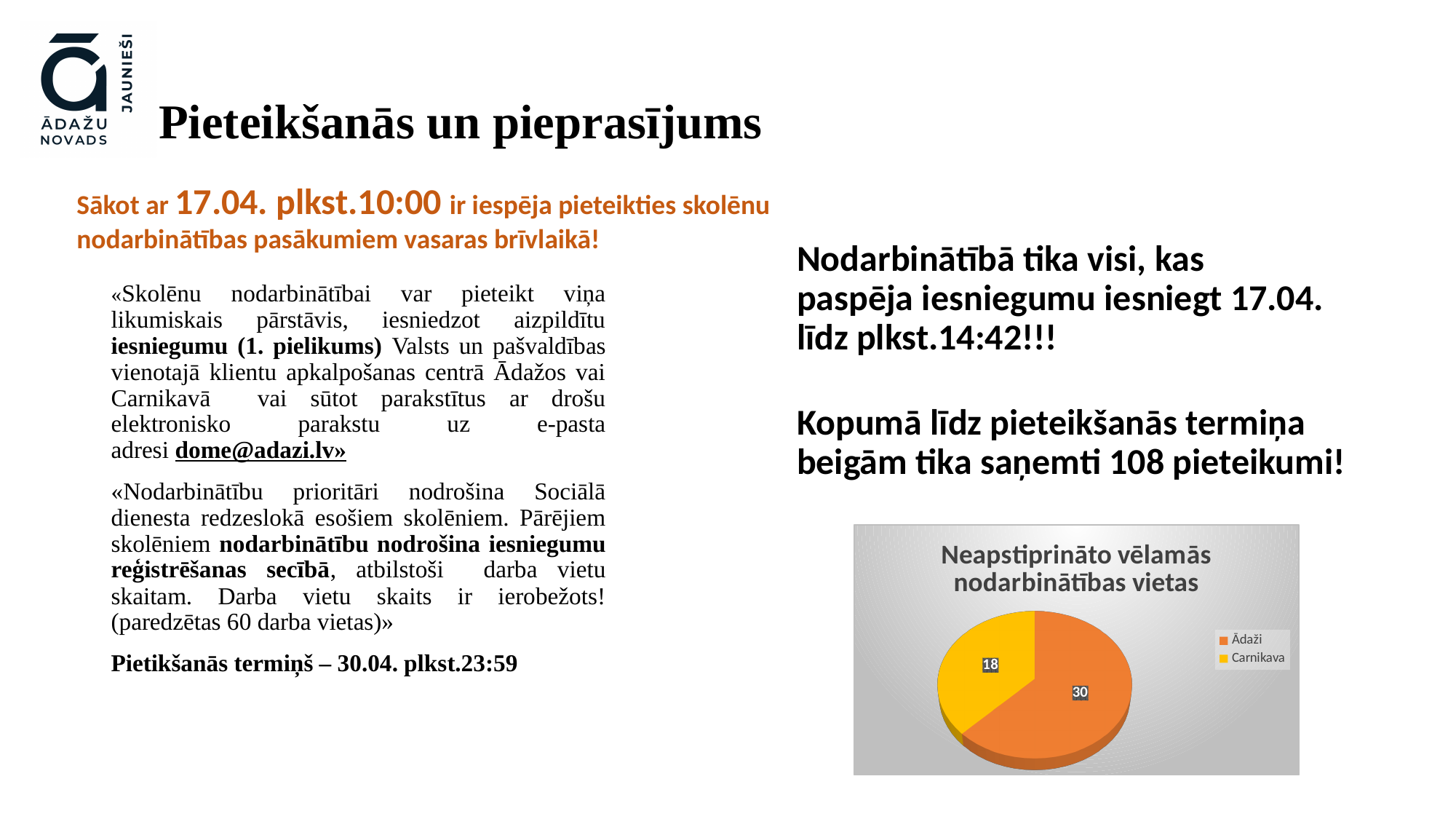
What colour is the Carnikava slice in the pie chart? yellow What is the value for Ādaži in the pie chart? 30 What is the title of the pie chart? Neapstiprināto vēlamās nodarbinātības vietas What kind of chart is shown on the slide? pie chart Which category has the largest slice in the pie chart? Ādaži What is the difference between the values for Ādaži and Carnikava in the pie chart? 12 Which category has the smallest slice in the pie chart? Carnikava How many categories does the pie chart show? 2 How many entries does the legend of the pie chart list? 2 Which is larger in the pie chart, Ādaži or Carnikava? Ādaži What is the total of all slices in the pie chart? 48 What is the value for Carnikava in the pie chart? 18